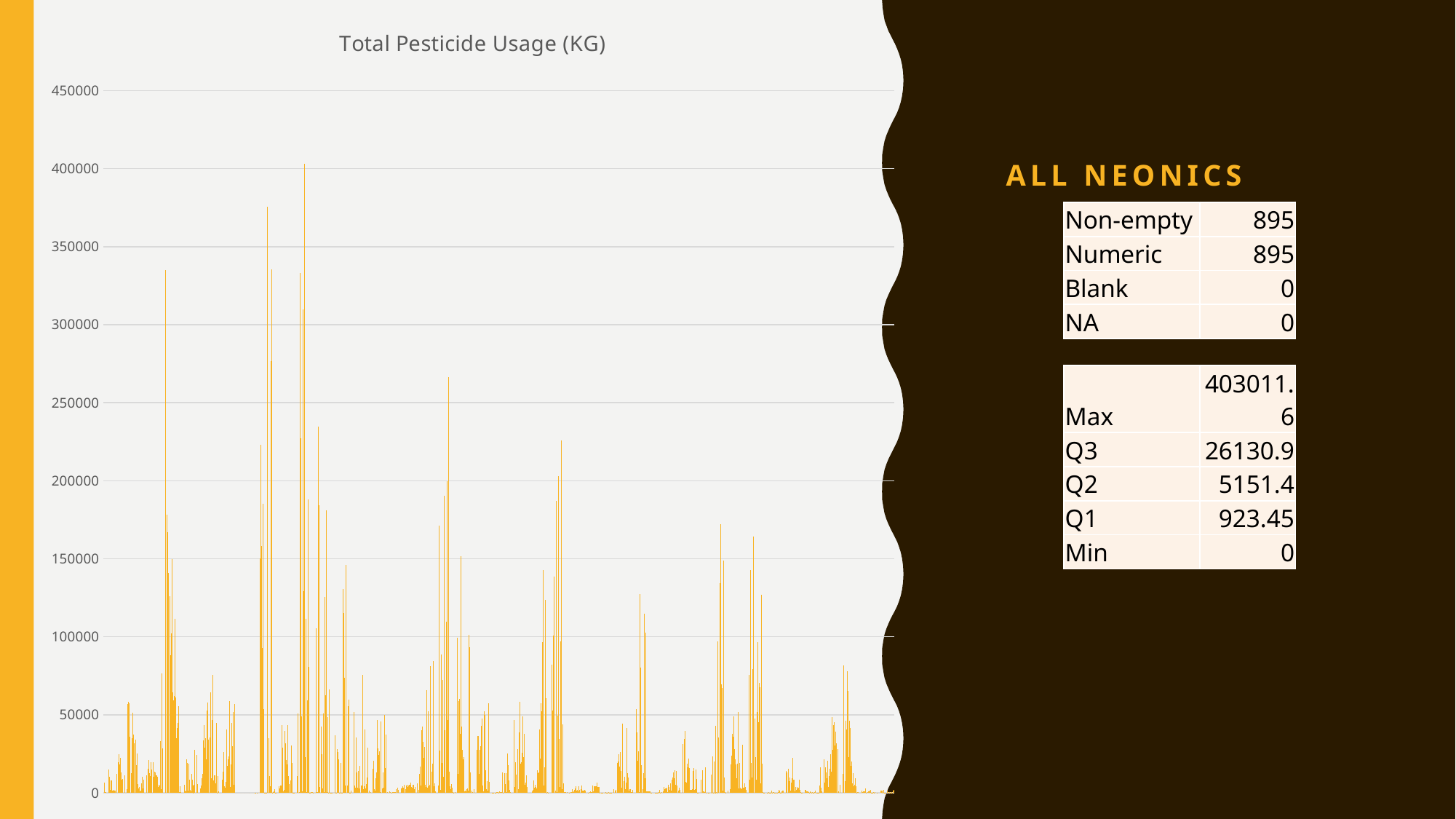
What kind of chart is shown on the slide? bar chart Are most of the bars in the chart above or below 50000? below What is the title of the chart? Total Pesticide Usage (KG) What is the highest tick value shown on the chart's vertical axis? 450000 Is the value of the tallest bar in the chart greater or less than 450000? less Is the value of the tallest bar in the chart greater or less than 400000? greater